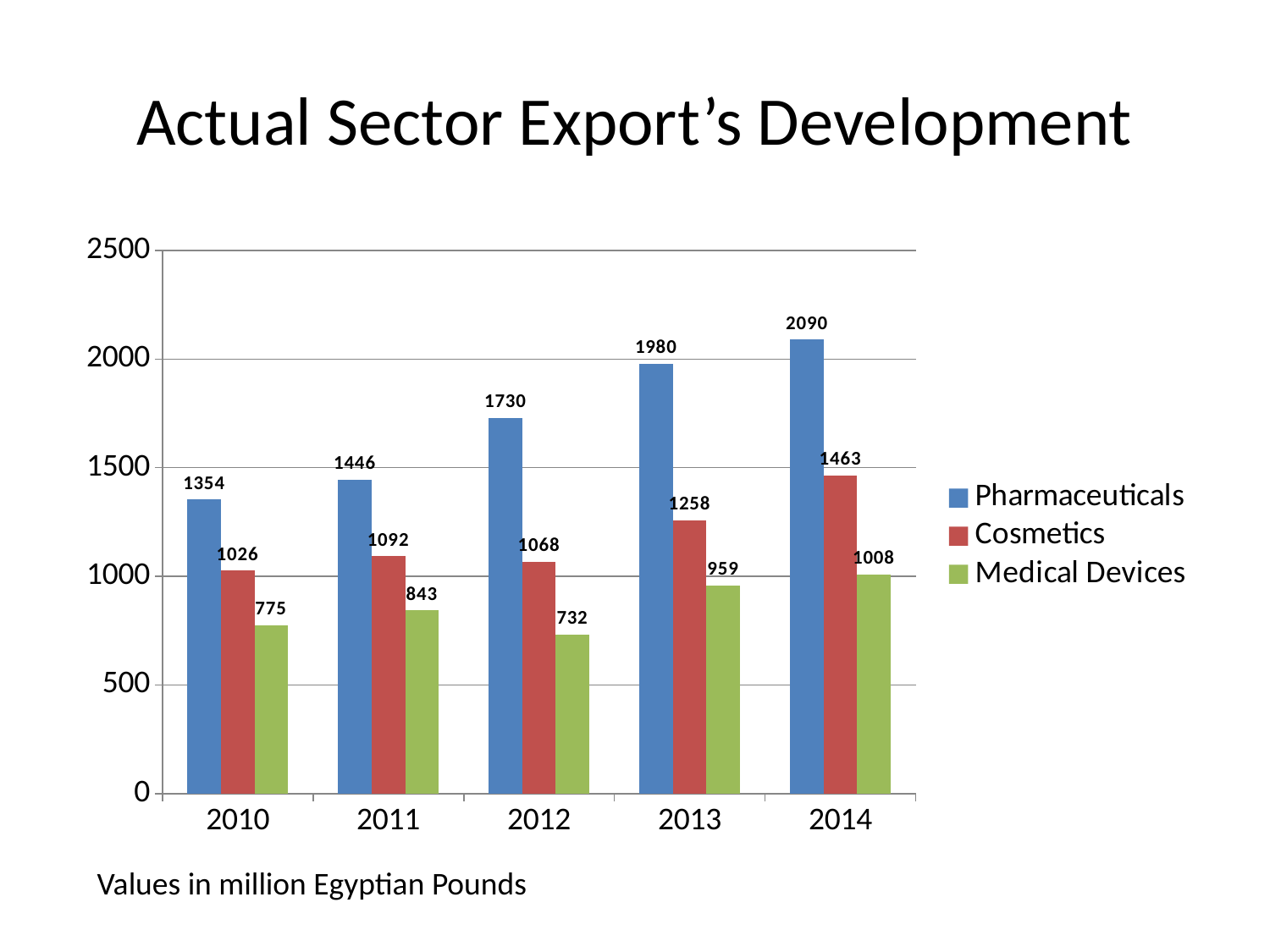
In which year is the Medical Devices value lowest? 2012 How many years are shown on the x axis? 5 What is the title of the chart? Actual Sector Export’s Development Which is larger: Cosmetics in 2011 or Cosmetics in 2012? Cosmetics in 2011 What is the value for Pharmaceuticals in 2012? 1730 What is the difference between the Pharmaceuticals value in 2014 and in 2013? 110 What kind of chart is shown on the slide? Bar chart What is the value for Cosmetics in 2014? 1463 What is the value for Medical Devices in 2010? 775 Do the Pharmaceuticals values rise or fall from 2010 to 2014? Rise How many series does the legend list? 3 In which year is the Pharmaceuticals value highest? 2014